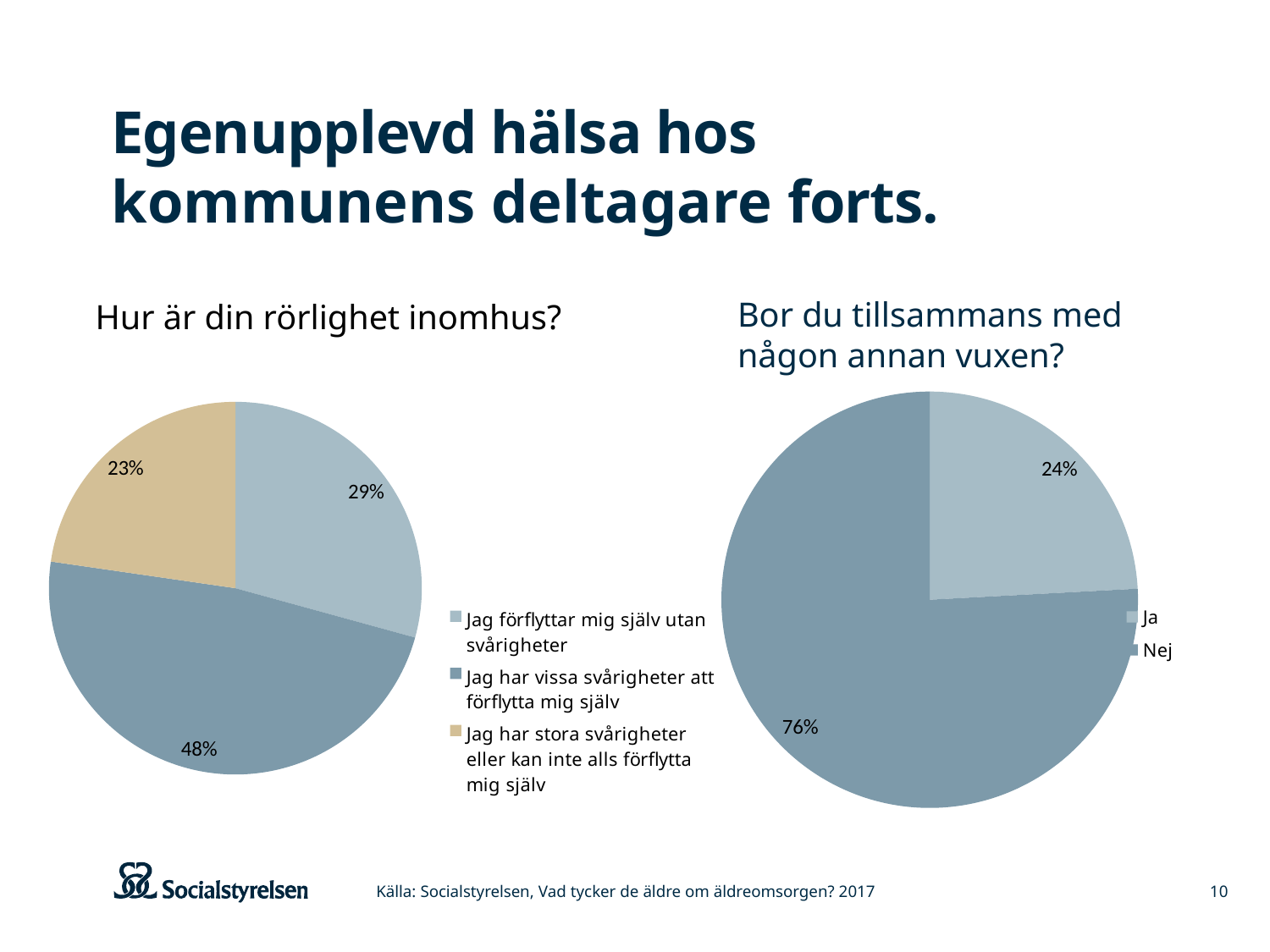
What type of chart is used for 'Bor du tillsammans med någon annan vuxen?'? Pie chart In the 'Bor du tillsammans med någon annan vuxen?' chart, which answer is larger, 'Ja' or 'Nej'? Nej In the 'Hur är din rörlighet inomhus?' chart, what share of respondents answered 'Jag har vissa svårigheter att förflytta mig själv'? 48% In the 'Hur är din rörlighet inomhus?' chart, what share answered 'Jag har stora svårigheter eller kan inte alls förflytta mig själv'? 23% In the 'Hur är din rörlighet inomhus?' chart, which answer has the largest share? Jag har vissa svårigheter att förflytta mig själv In the 'Hur är din rörlighet inomhus?' chart, what is the difference in percentage points between the 48% slice and the 29% slice? 19 percentage points In the 'Hur är din rörlighet inomhus?' chart, what share answered 'Jag förflyttar mig själv utan svårigheter'? 29% How many slices does the 'Hur är din rörlighet inomhus?' pie chart have? 3 How many entries does the legend of the 'Bor du tillsammans med någon annan vuxen?' chart list? 2 In the 'Hur är din rörlighet inomhus?' chart, which answer has the smallest share? Jag har stora svårigheter eller kan inte alls förflytta mig själv In the 'Bor du tillsammans med någon annan vuxen?' chart, what share answered 'Nej'? 76% In the 'Bor du tillsammans med någon annan vuxen?' chart, what share answered 'Ja'? 24%